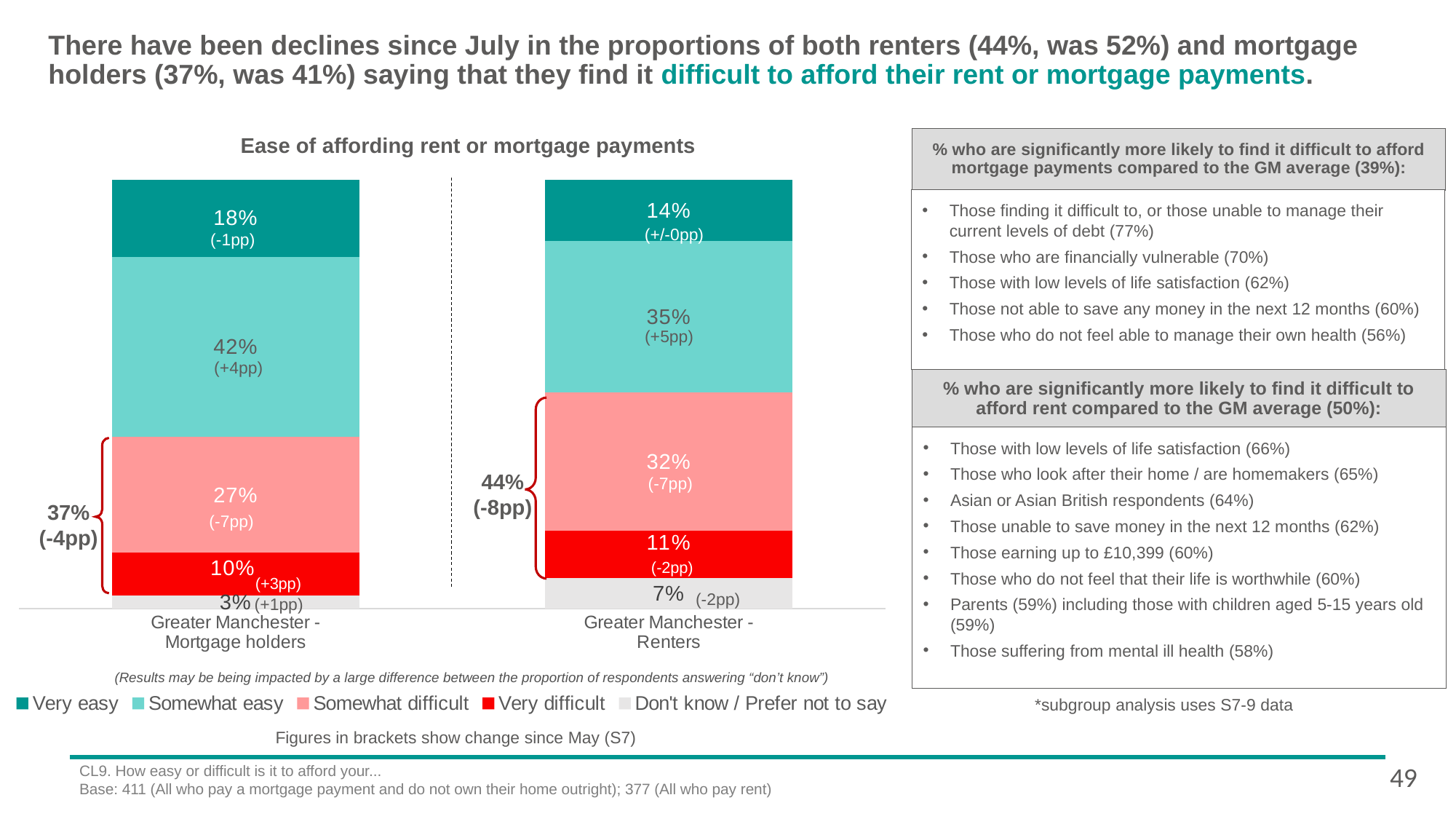
What is the "Very easy" value for Greater Manchester - Mortgage holders? 18% How many series does the legend list? 5 What is the "Very difficult" value for Greater Manchester - Renters? 11% How many categories (bars) are plotted on the chart? 2 What is the combined total of the "Somewhat difficult" and "Very difficult" segments for Greater Manchester - Renters? 44% What is the difference between the "Somewhat easy" values for Mortgage holders (42%) and Renters (35%)? 7 percentage points What is the "Don't know / Prefer not to say" value for Greater Manchester - Renters? 7% Which category has the higher "Somewhat difficult" value, Mortgage holders or Renters? Renters What kind of chart is shown under the title "Ease of affording rent or mortgage payments"? Stacked bar chart Which segment is the smallest in the Greater Manchester - Mortgage holders bar? Don't know / Prefer not to say Which segment is the largest in the Greater Manchester - Renters bar? Somewhat easy What is the "Somewhat easy" value for Greater Manchester - Mortgage holders? 42%